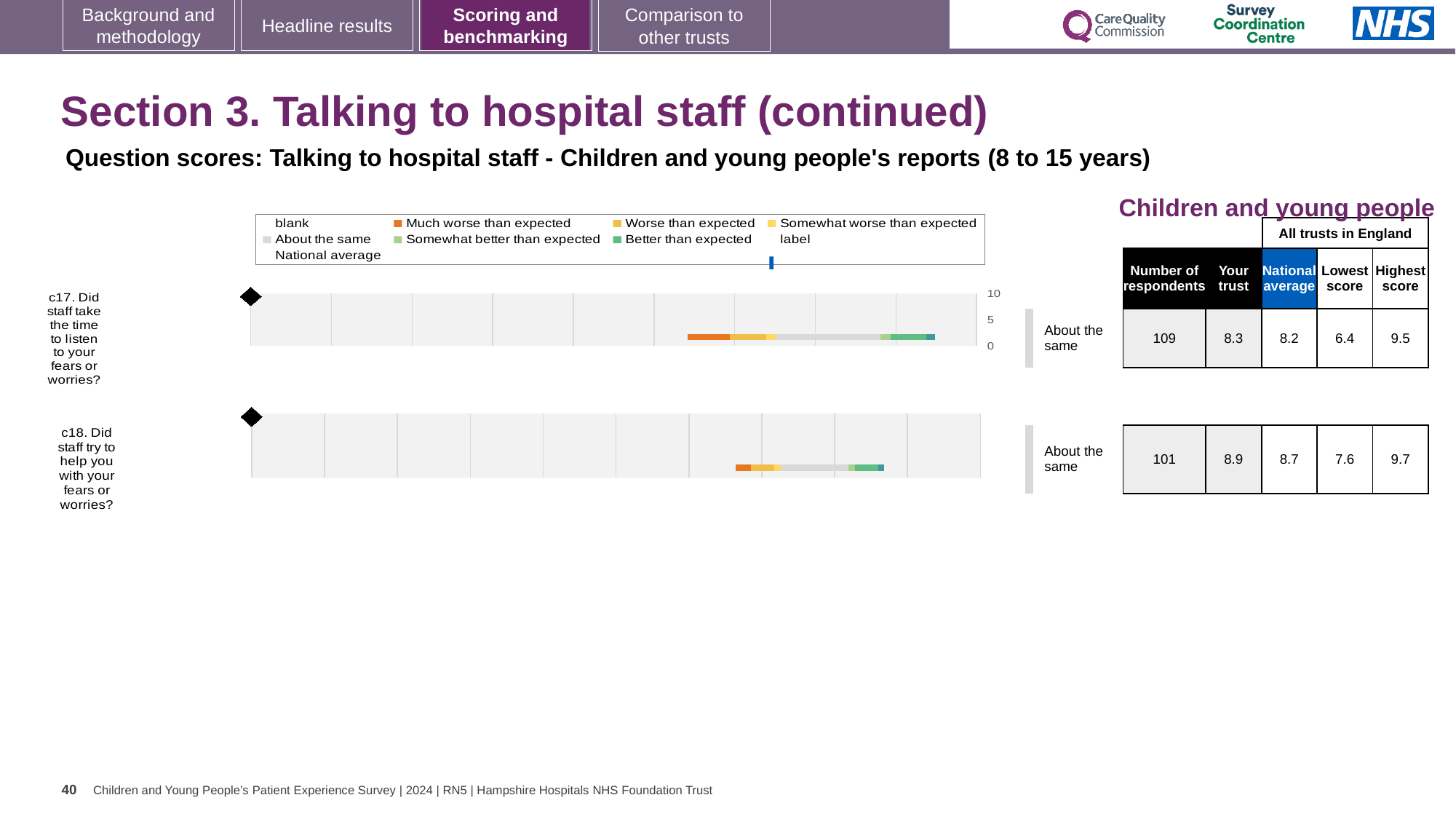
What kind of chart is used to show the question scores for c17 and c18? bar chart Which question has the higher 'Your trust' score, c17 or c18? c18 How many respondents answered question c17? 109 What is the national average score for question c18 (Did staff try to help you with your fears or worries?)? 8.7 What is the lowest score across all trusts in England for question c17? 6.4 What is the heading above the table of scores on the right of the slide? Children and young people What is the highest score across all trusts in England for question c18? 9.7 What is the difference between the highest and lowest scores for question c17? 3.1 What is the 'Your trust' score for question c17 (Did staff take the time to listen to your fears or worries?)? 8.3 By how much does the trust's score for c18 exceed the national average? 0.2 How many questions (c17 and c18) are plotted on the slide? 2 What benchmark category is shown for question c17? About the same